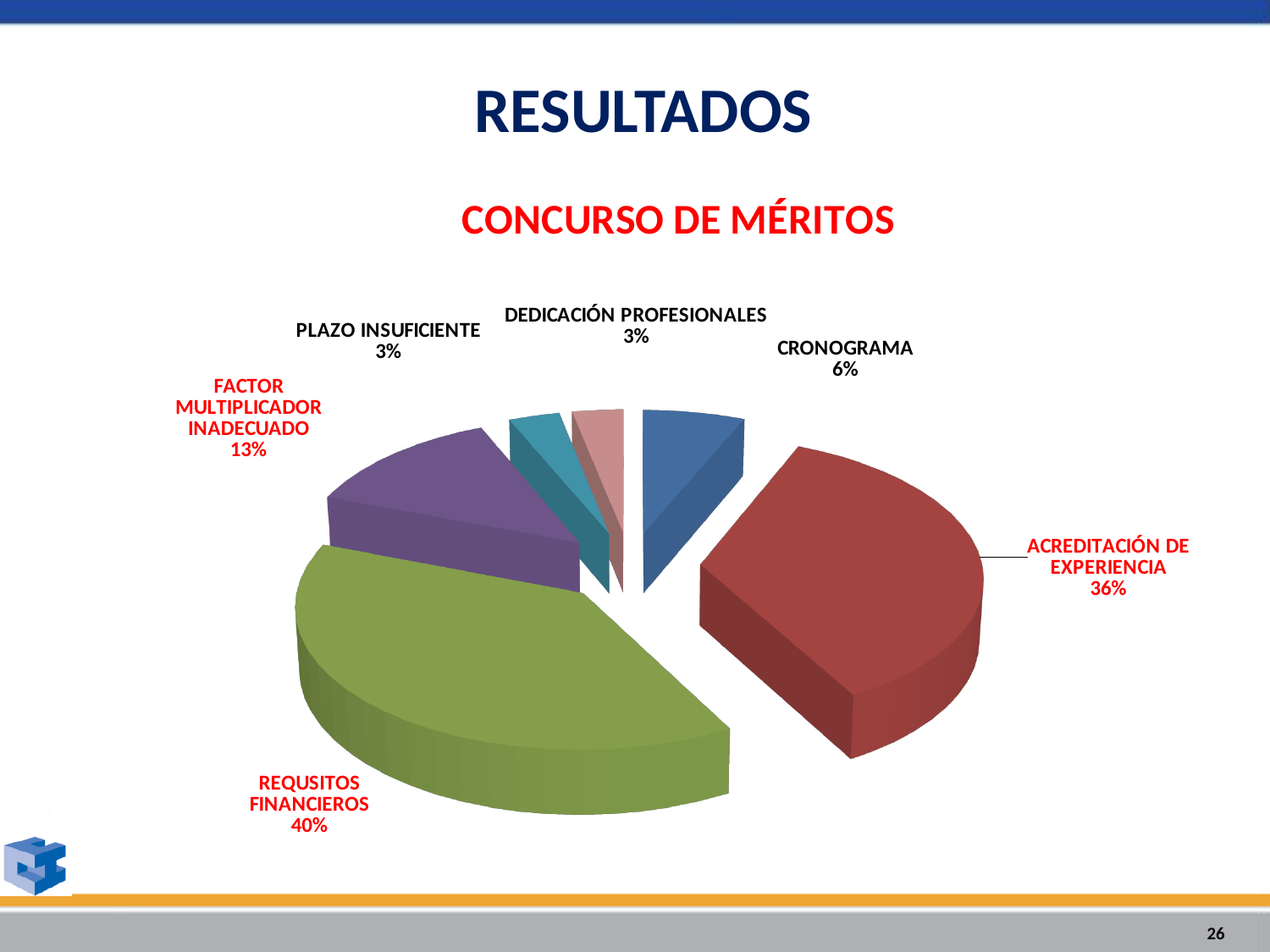
What share of the pie does REQUSITOS FINANCIEROS have? 40% What is the difference between the shares of REQUSITOS FINANCIEROS and ACREDITACIÓN DE EXPERIENCIA? 4% Which category has the largest share of the pie? REQUSITOS FINANCIEROS What is the value for PLAZO INSUFICIENTE? 3% What is the value for FACTOR MULTIPLICADOR INADECUADO? 13% How many categories are shown in the pie chart? 6 What is the value for CRONOGRAMA? 6% What type of chart is shown on the slide? Pie chart What is the subtitle shown above the pie chart? CONCURSO DE MÉRITOS Which is larger, the share for FACTOR MULTIPLICADOR INADECUADO or the share for CRONOGRAMA? FACTOR MULTIPLICADOR INADECUADO What is the difference between the shares of CRONOGRAMA and DEDICACIÓN PROFESIONALES? 3% What share of the pie does ACREDITACIÓN DE EXPERIENCIA have? 36%